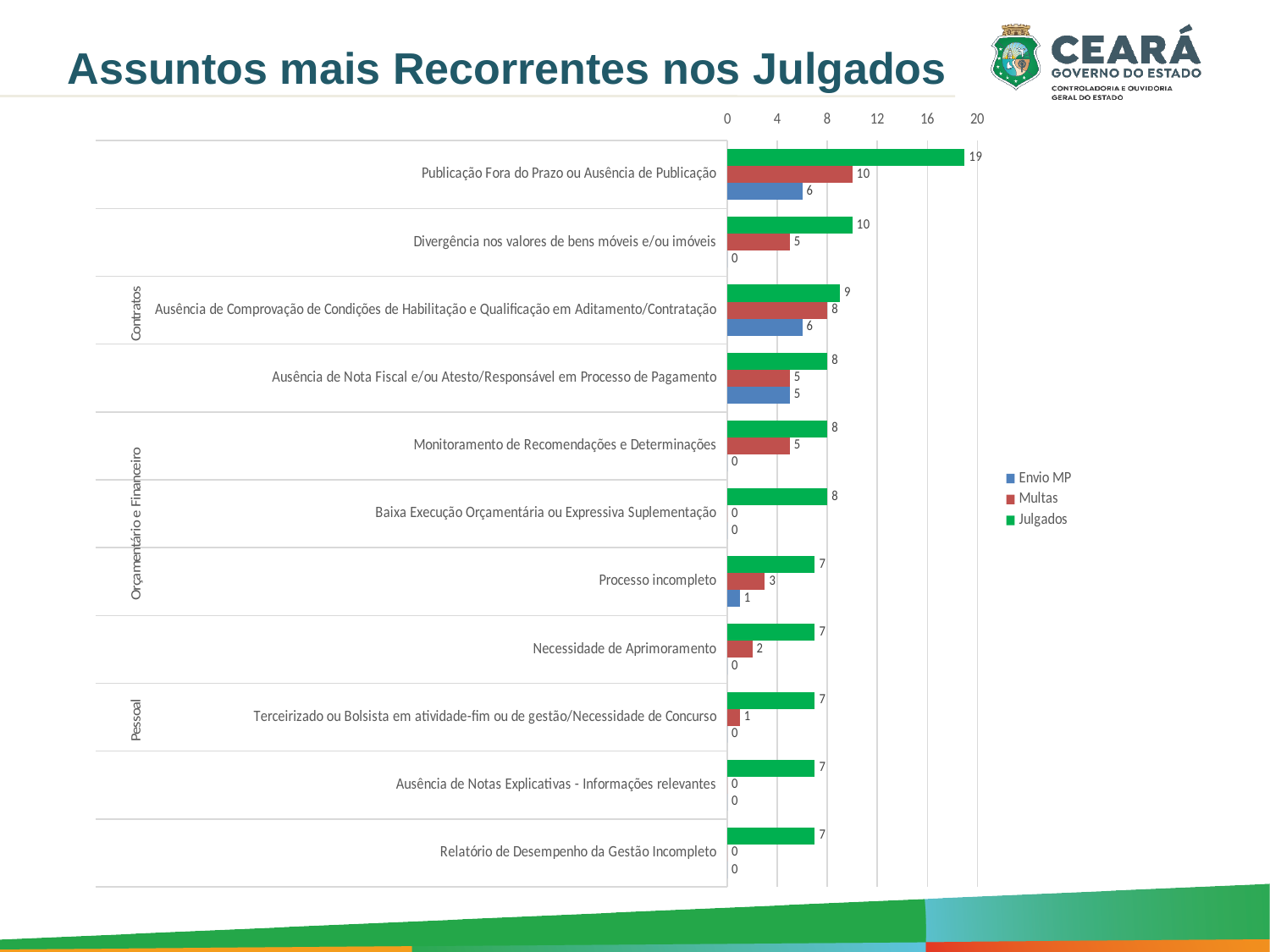
What kind of chart is shown on the slide? Bar chart Which is larger for 'Divergência nos valores de bens móveis e/ou imóveis': the Julgados value or the Multas value? Julgados What is the difference between the Julgados and Multas values for 'Publicação Fora do Prazo ou Ausência de Publicação'? 9 How many series does the legend list? 3 Which series is shown in green in the legend? Julgados What is the Multas value for 'Ausência de Comprovação de Condições de Habilitação e Qualificação em Aditamento/Contratação'? 8 How many categories (subjects) are plotted in the chart? 11 What is the Multas value for 'Necessidade de Aprimoramento'? 2 Which category has the highest Julgados value? Publicação Fora do Prazo ou Ausência de Publicação What is the Envio MP value for 'Processo incompleto'? 1 What is the Julgados value for 'Publicação Fora do Prazo ou Ausência de Publicação'? 19 Is the Julgados value for 'Publicação Fora do Prazo ou Ausência de Publicação' greater or less than 16? greater